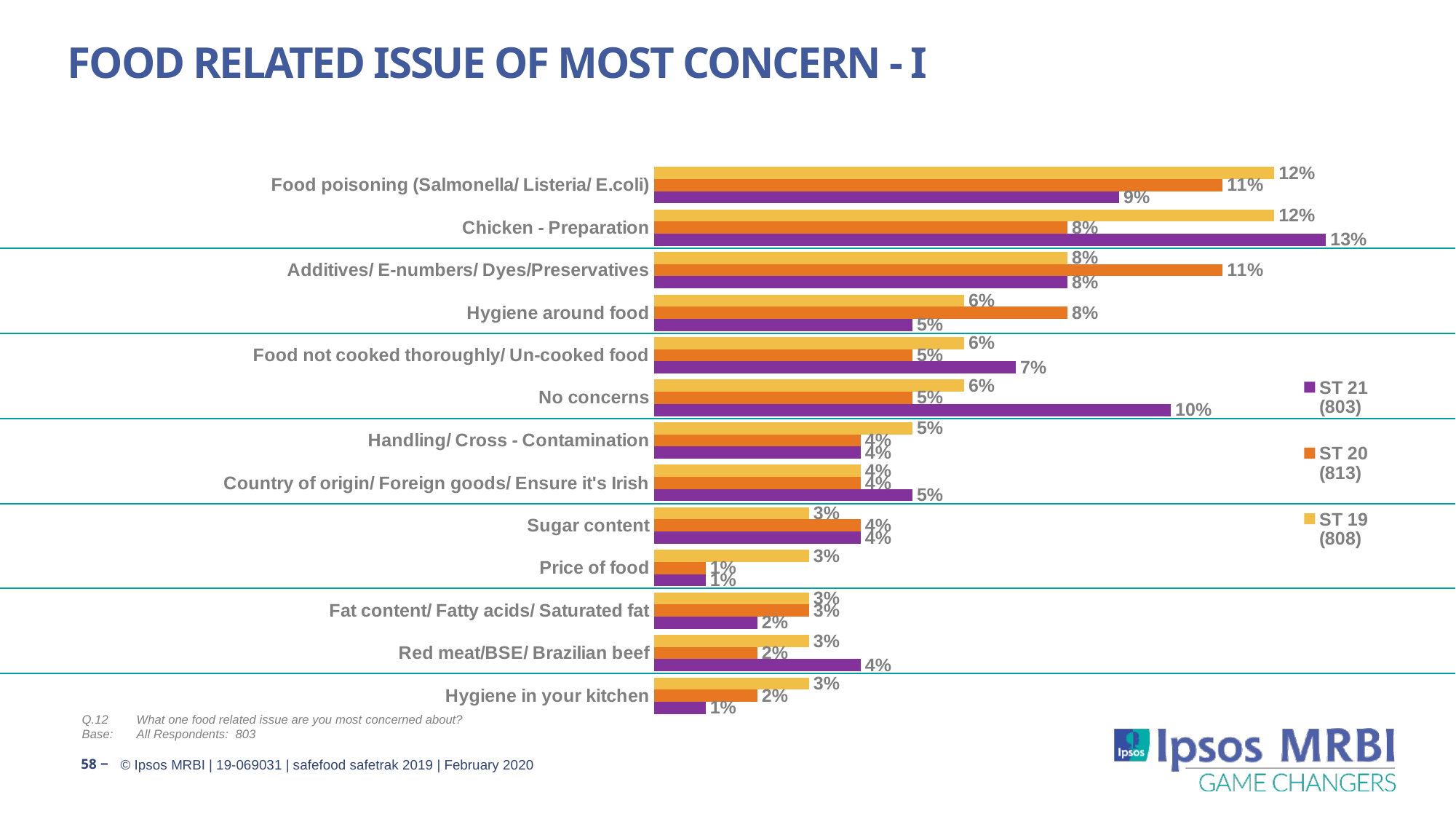
What is the ST 20 value for Additives/ E-numbers/ Dyes/Preservatives? 11% What is the difference between the ST 19 and ST 20 values for Price of food? 2% How many series does the legend list? 3 What is the ST 19 value for Food poisoning (Salmonella/ Listeria/ E.coli)? 12% What kind of chart is shown on the slide? bar chart What is the ST 21 value for No concerns? 10% For Food poisoning (Salmonella/ Listeria/ E.coli), which is larger: the ST 19 value or the ST 21 value? ST 19 What is the ST 21 value for Chicken - Preparation? 13% What is the difference between the ST 21 and ST 20 values for No concerns? 5% How many food-related issue categories are plotted on the chart? 13 Which category has the highest ST 21 value? Chicken - Preparation Which series is shown in purple in the legend? ST 21 (803)